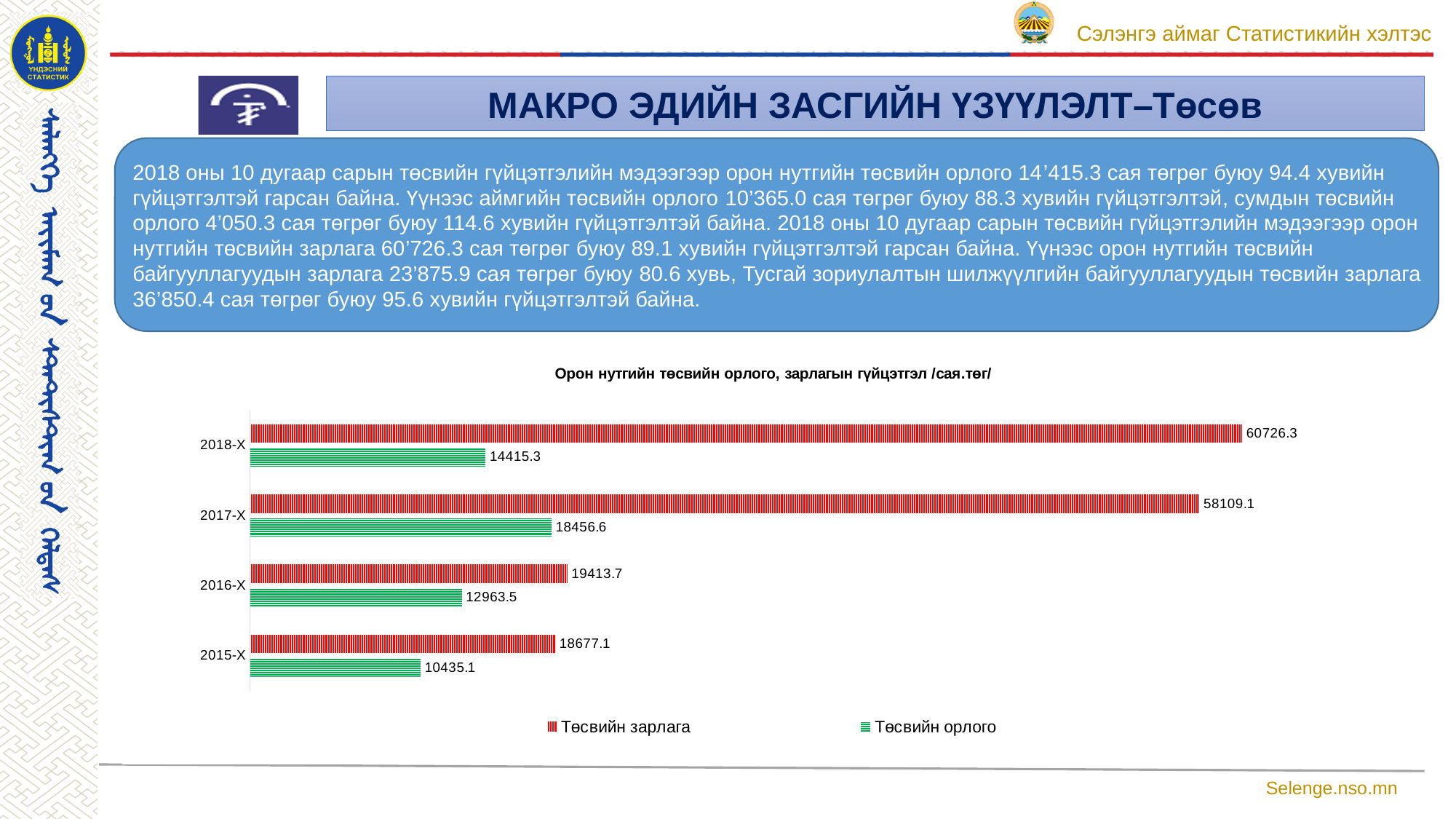
Which is larger: Төсвийн зарлага for 2016-X or Төсвийн зарлага for 2015-X? 2016-X What is the value of Төсвийн зарлага for 2016-X? 19413.7 Which year has the lowest Төсвийн зарлага value? 2015-X What is the value of Төсвийн зарлага for 2018-X? 60726.3 Which year has the highest Төсвийн орлого value? 2017-X What is the value of Төсвийн орлого for 2015-X? 10435.1 What is the value of Төсвийн орлого for 2017-X? 18456.6 How many years (categories) are shown in the chart? 4 What type of chart is shown on the slide? Bar chart How many series does the legend list? 2 What is the difference between Төсвийн зарлага and Төсвийн орлого for 2018-X? 46311.0 How much higher is Төсвийн орлого in 2017-X than in 2018-X? 4041.3